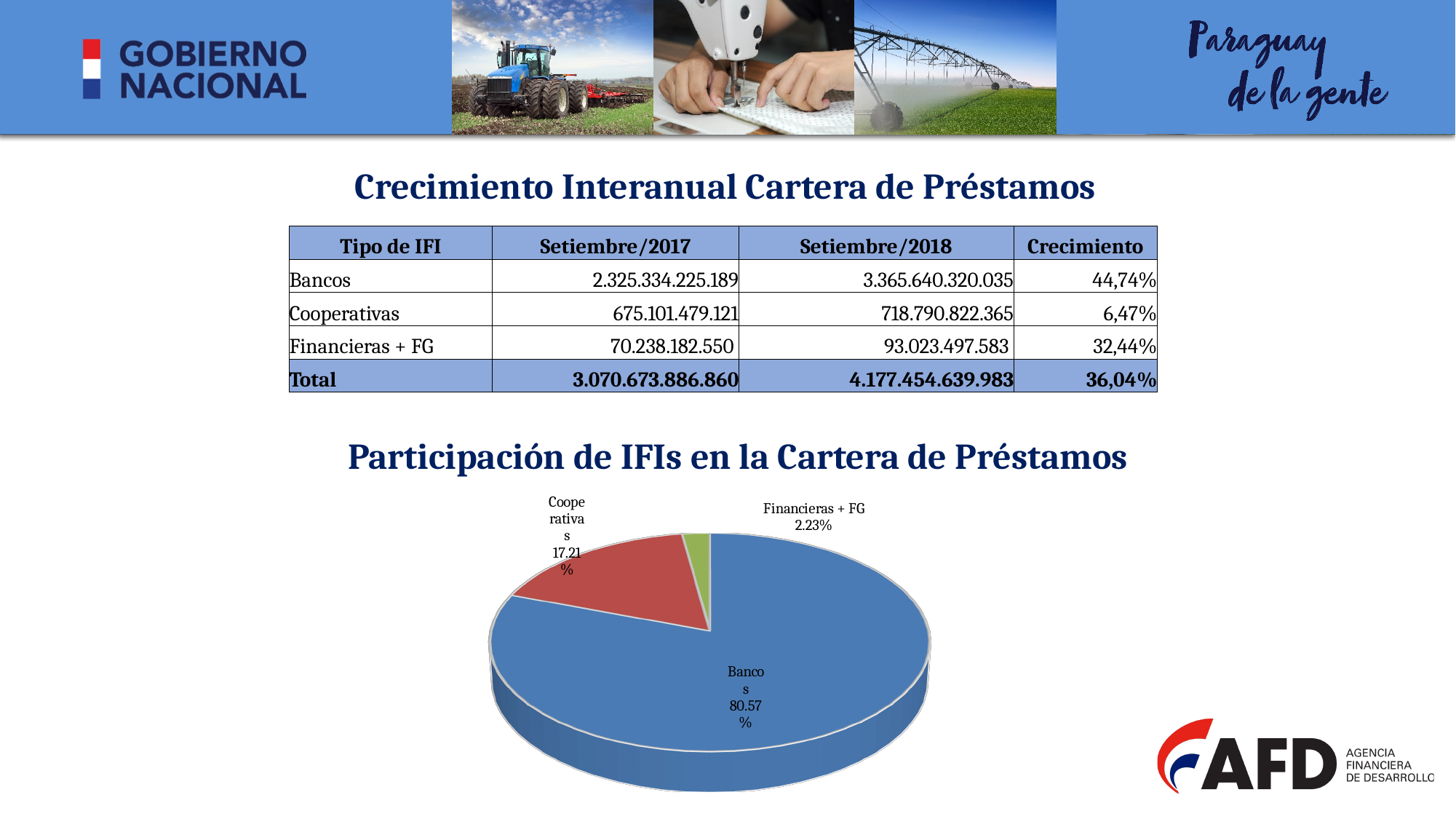
What kind of chart is shown under the title "Participación de IFIs en la Cartera de Préstamos"? Pie chart Which category has the smallest slice in the pie chart? Financieras + FG What colour is the Cooperativas slice in the pie chart? Red In the pie chart, what share of the loan portfolio do Bancos hold? 80.57% In the pie chart, what share is shown for Financieras + FG? 2.23% In the pie chart, by how many percentage points does the Bancos share exceed the Cooperativas share? 63.36 percentage points How many slices does the pie chart have? 3 In the pie chart, what share is shown for Cooperativas? 17.21% In the pie chart, which is larger: the share of Cooperativas or the share of Financieras + FG? Cooperativas What is the title of the pie chart on the slide? Participación de IFIs en la Cartera de Préstamos In the pie chart, by how many percentage points does the Cooperativas share exceed the Financieras + FG share? 14.98 percentage points Which category has the largest slice in the pie chart? Bancos